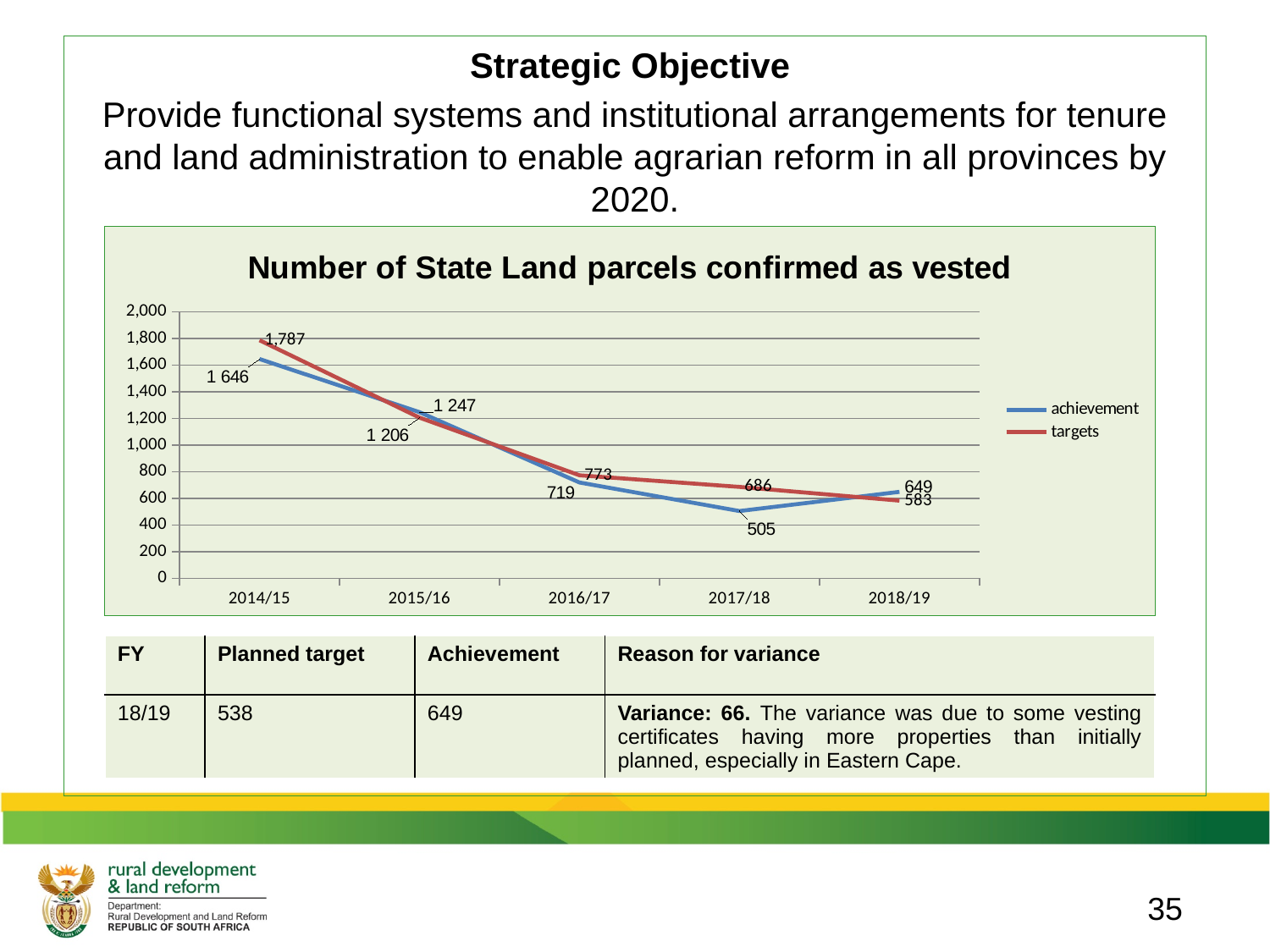
Does the targets series rise or fall from 2014/15 to 2018/19? fall By how much does the targets value exceed the achievement value in 2017/18? 181 In 2018/19, which is larger: achievement or targets? achievement What is the targets value for 2014/15? 1,787 What is the targets value for 2018/19? 583 How many financial years are plotted along the x axis of the chart? 5 What kind of chart is shown on the slide? line chart What is the achievement value for 2014/15? 1 646 What is the achievement value for 2017/18? 505 In which financial year is the achievement value lowest? 2017/18 How many series does the legend of the chart list? 2 In which financial year is the achievement value highest? 2014/15